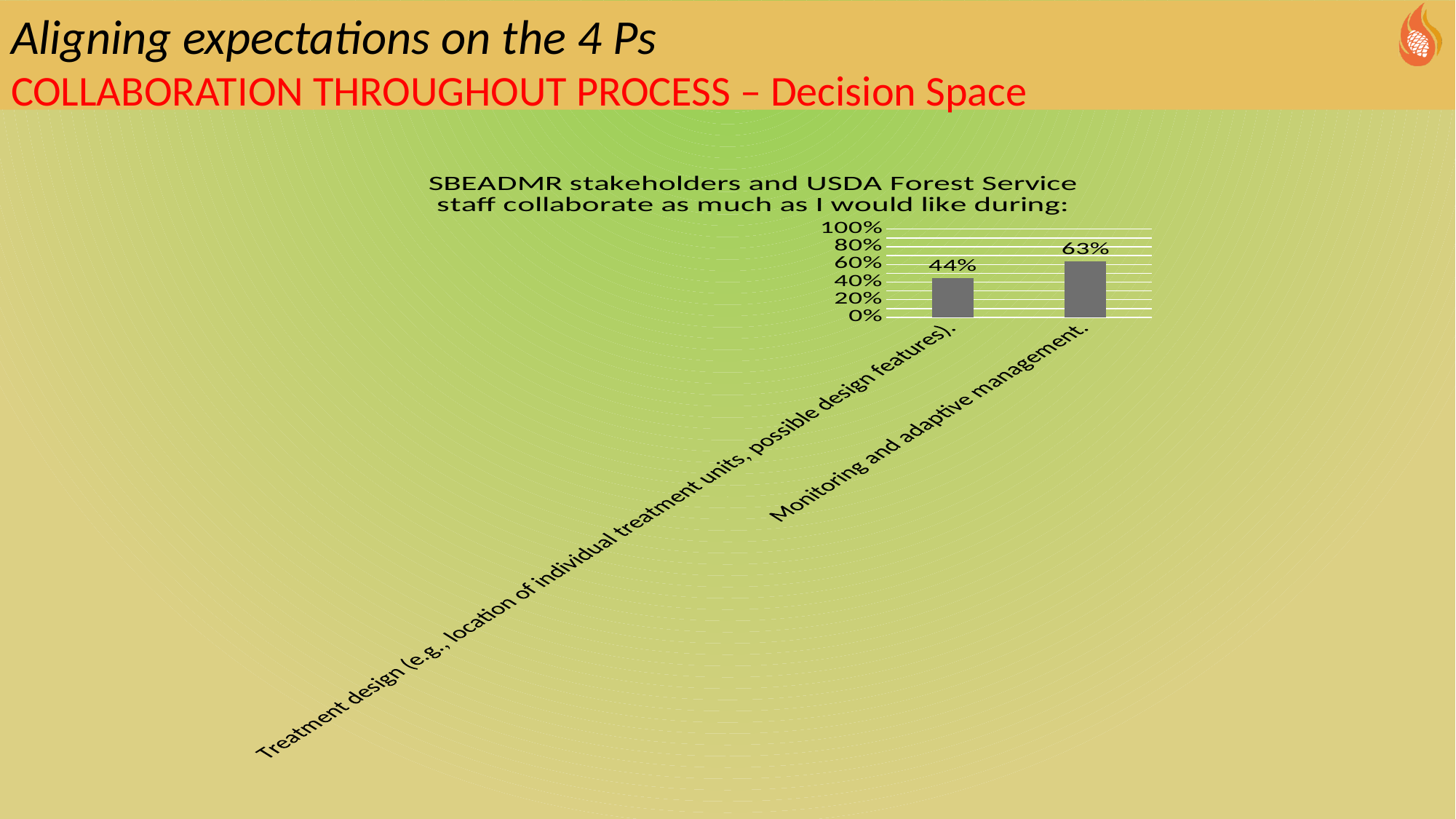
Which category has the higher value? Monitoring and adaptive management. What kind of chart is shown on the slide? bar chart Is the value for 'Monitoring and adaptive management' greater or less than 60%? greater What percentage is shown for 'Monitoring and adaptive management'? 63% What is the maximum value shown on the vertical axis? 100% What is the title of the chart? SBEADMR stakeholders and USDA Forest Service staff collaborate as much as I would like during: How many categories are plotted in the chart? 2 What is the difference in percentage points between 'Monitoring and adaptive management' and 'Treatment design'? 19 Is the value for 'Treatment design' greater or less than 60%? less Which category has the lower value? Treatment design (e.g., location of individual treatment units, possible design features). What percentage is shown for 'Treatment design (e.g., location of individual treatment units, possible design features)'? 44%